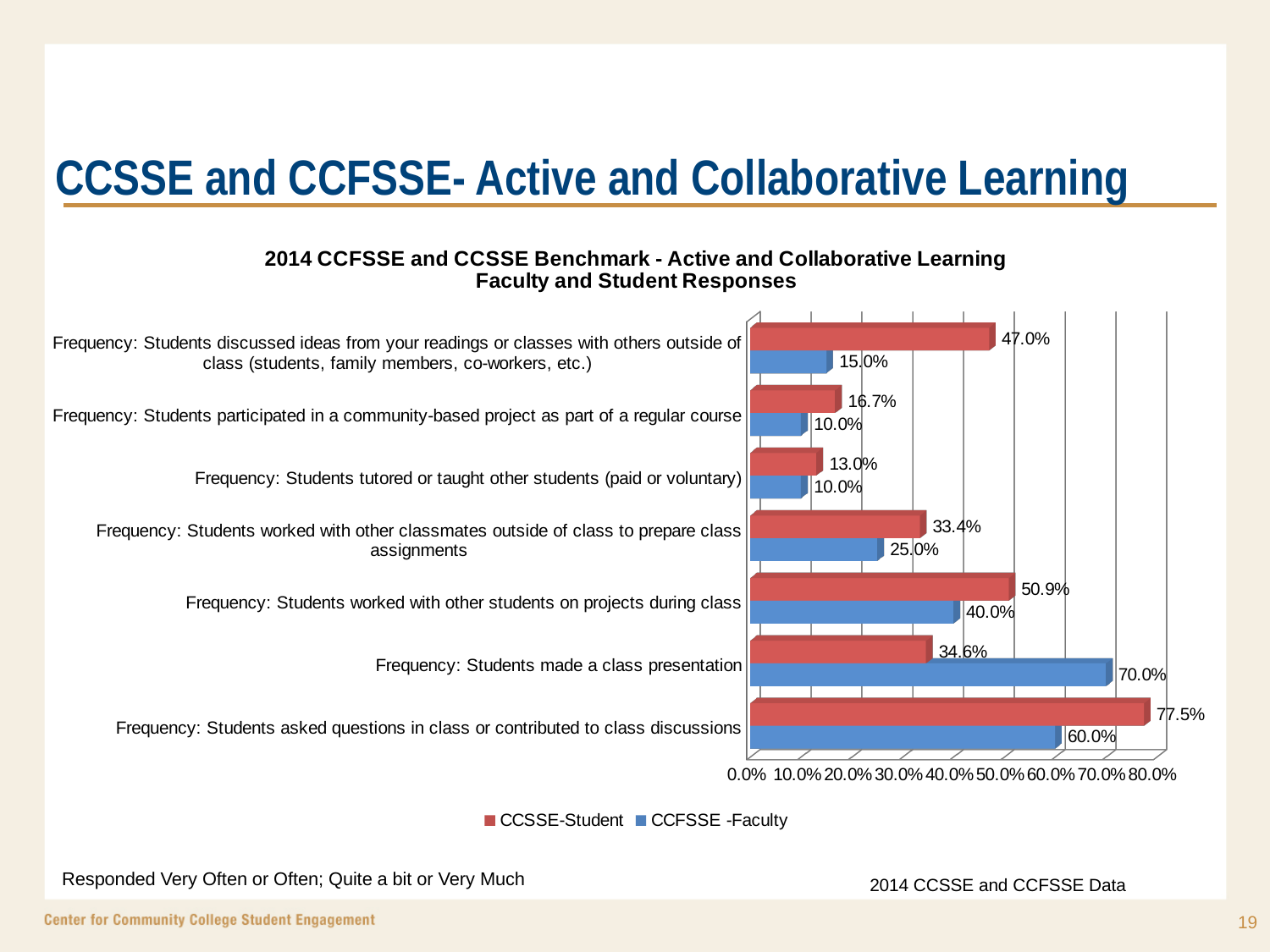
What is the CCFSSE-Faculty value for "Frequency: Students made a class presentation"? 70.0% What is the CCSSE-Student value for "Frequency: Students worked with other students on projects during class"? 50.9% What is the CCSSE-Student value for "Frequency: Students asked questions in class or contributed to class discussions"? 77.5% How many series does the legend list? 2 Which category has the lowest CCSSE-Student value? Frequency: Students tutored or taught other students (paid or voluntary) What is the difference between the CCFSSE-Faculty and CCSSE-Student values for "Frequency: Students made a class presentation"? 35.4 percentage points What kind of chart is shown on the slide? Bar chart Which category has the highest CCSSE-Student value? Frequency: Students asked questions in class or contributed to class discussions Which category has the highest CCFSSE-Faculty value? Frequency: Students made a class presentation For "Frequency: Students worked with other classmates outside of class to prepare class assignments", which is larger, the CCSSE-Student value or the CCFSSE-Faculty value? CCSSE-Student What is the CCFSSE-Faculty value for "Frequency: Students discussed ideas from your readings or classes with others outside of class"? 15.0% How many categories are shown in the chart? 7